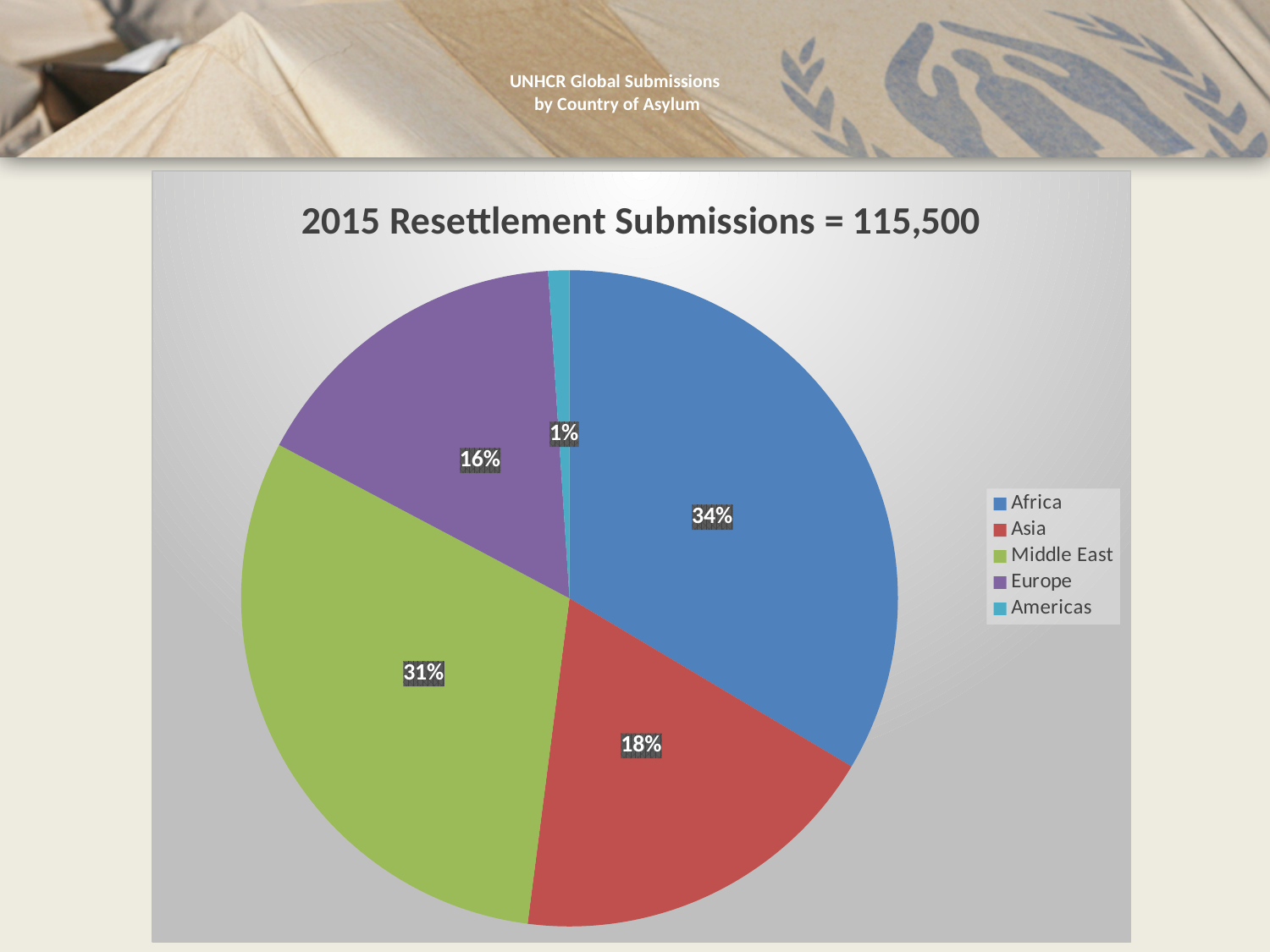
How many regions does the legend list? 5 What share of 2015 resettlement submissions came from Africa? 34% Which has a larger share, Asia or Europe? Asia What kind of chart is shown on the slide? pie chart What share of 2015 resettlement submissions came from the Americas? 1% What share of 2015 resettlement submissions came from Europe? 16% Which region has the largest share of 2015 resettlement submissions? Africa What is the title of the chart? 2015 Resettlement Submissions = 115,500 How many percentage points larger is the Middle East share than the Europe share? 15 Which region has the smallest share of 2015 resettlement submissions? Americas